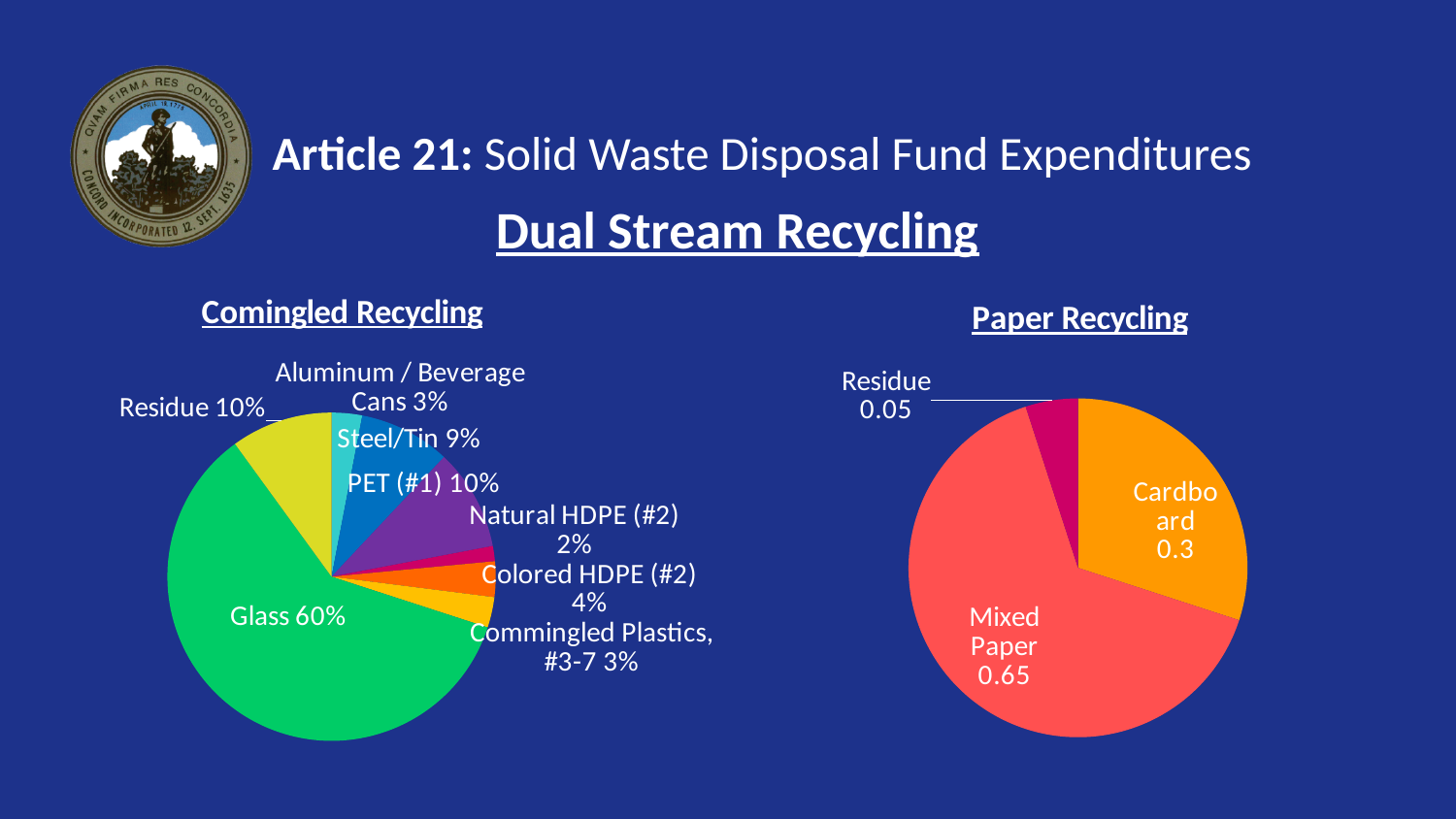
In the Comingled Recycling chart, what is the value for Steel/Tin? 9% In the Comingled Recycling chart, what share does Glass have? 60% In the Paper Recycling chart, which category has the smallest value? Residue In the Comingled Recycling chart, which category has the largest share? Glass What type of chart is the Paper Recycling chart? Pie chart How many categories are shown in the Comingled Recycling chart? 8 In the Comingled Recycling chart, which is larger: Steel/Tin or Aluminum / Beverage Cans? Steel/Tin In the Paper Recycling chart, what is the value for Cardboard? 0.3 In the Comingled Recycling chart, what is the difference between the Residue share and the Colored HDPE (#2) share? 6% In the Paper Recycling chart, what is the value for Mixed Paper? 0.65 In the Comingled Recycling chart, which category has the smallest share? Natural HDPE (#2) In the Comingled Recycling chart, what is the value for Natural HDPE (#2)? 2%